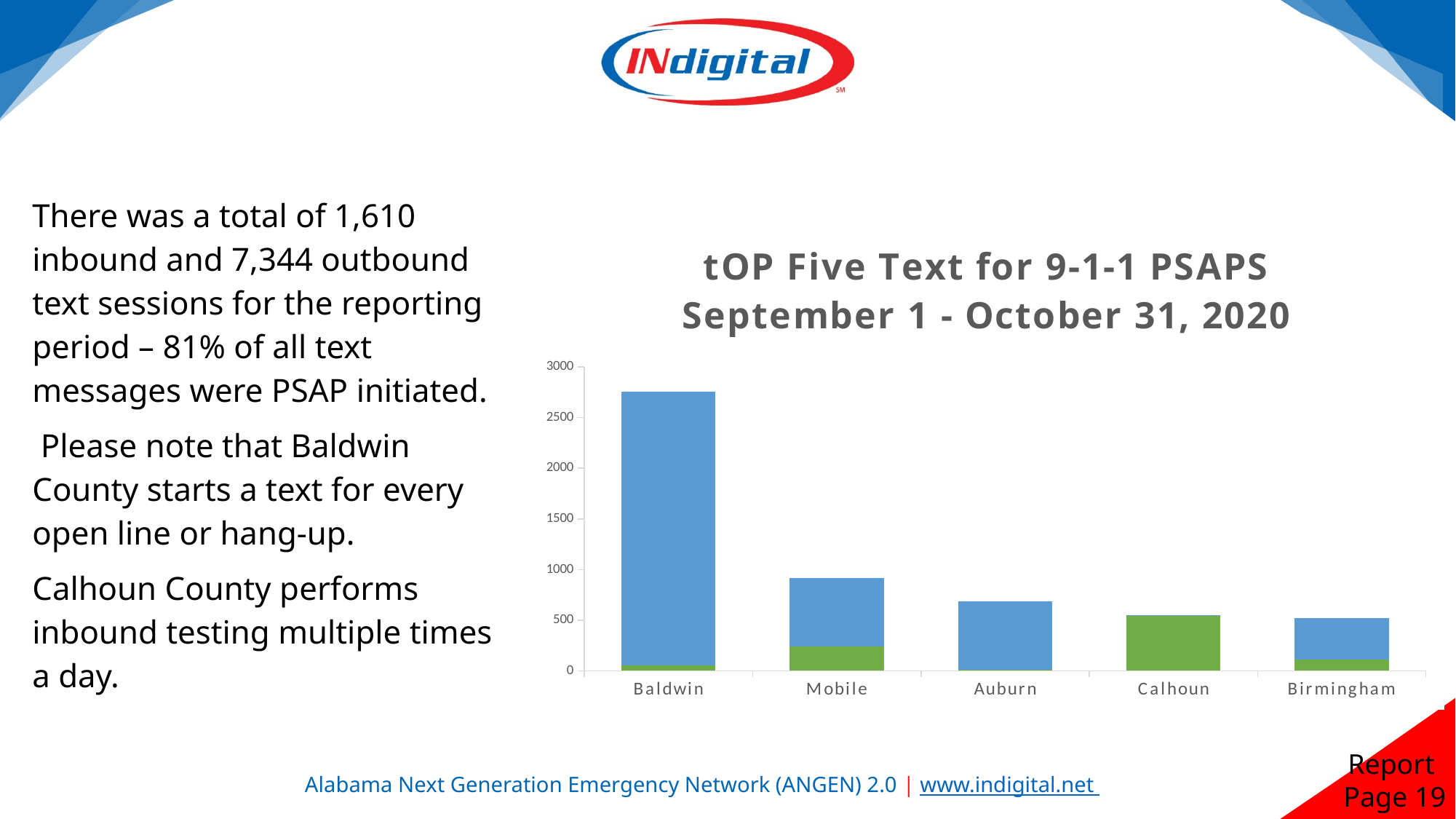
What is the title of the chart? tOP Five Text for 9-1-1 PSAPS September 1 - October 31, 2020 Which has a taller bar, Baldwin or Mobile? Baldwin Which PSAP has the highest bar in the chart? Baldwin Is the total value for Auburn greater or less than 1000? less How many PSAPs (categories) are shown on the x axis of the chart? 5 Is the total value for Baldwin greater or less than 2500? greater Which has a taller bar, Mobile or Auburn? Mobile What kind of chart is shown on the slide? bar chart Which PSAP's bar is made up entirely of the green segment? Calhoun Is the total value for Auburn greater or less than 500? greater Do the bar heights generally rise or fall from Baldwin to Birmingham along the x axis? fall